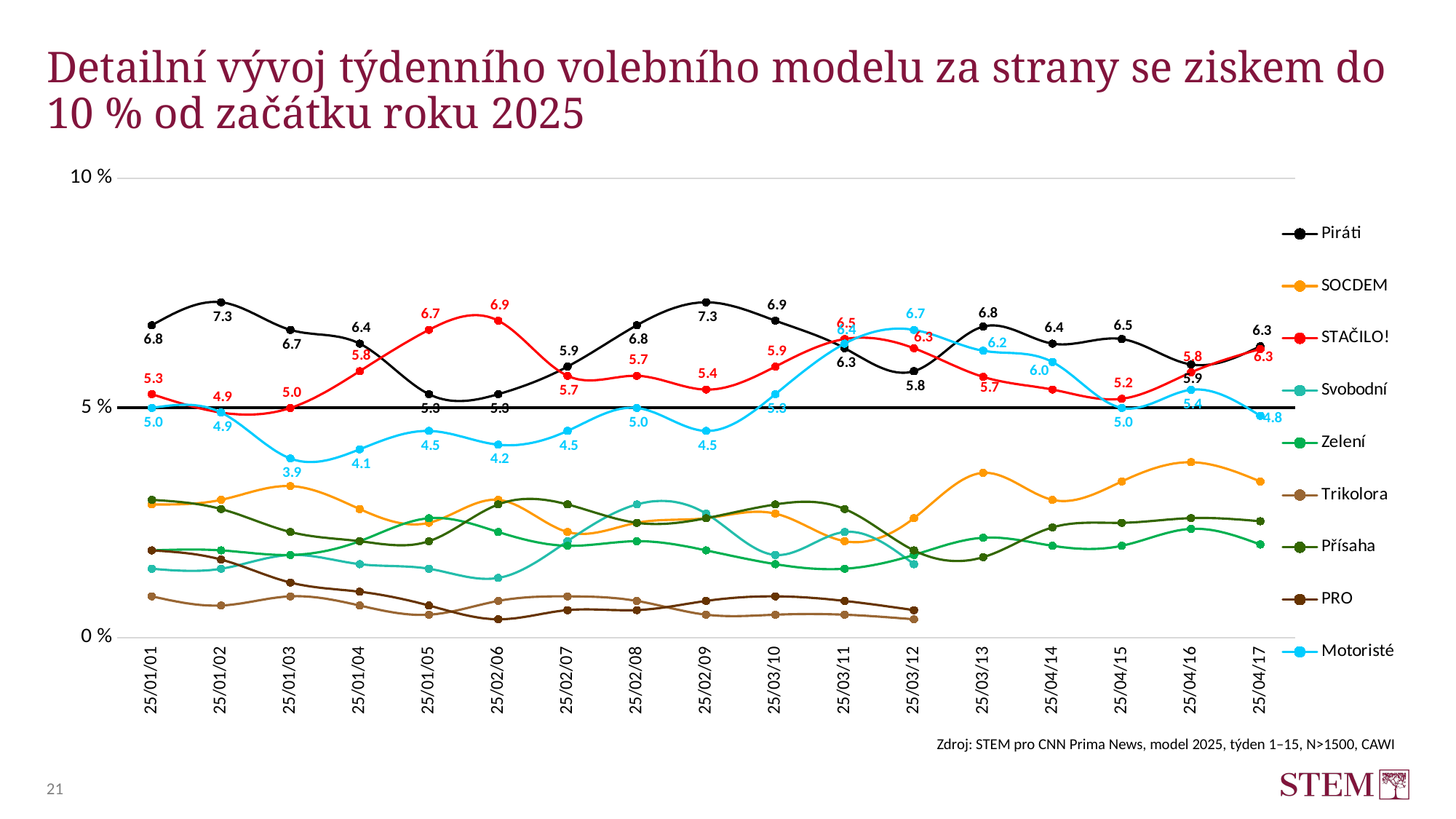
How many series does the legend list? 9 What is the value for Piráti at 25/01/02? 7.3 At which date does Motoristé have its lowest value? 25/01/03 Is the value for Motoristé at 25/01/04 greater or less than 5 %? less What is the value for STAČILO! at 25/02/06? 6.9 How many dates are shown on the x axis? 17 At which date does Motoristé reach its highest value? 25/03/12 What is the difference between Piráti and STAČILO! at 25/01/02? 2.4 What kind of chart is shown on the slide? line chart At what level is the bold horizontal reference line drawn across the chart? 5 % At 25/02/06, which is higher: Piráti or STAČILO!? STAČILO! What is the value for Motoristé at 25/01/03? 3.9